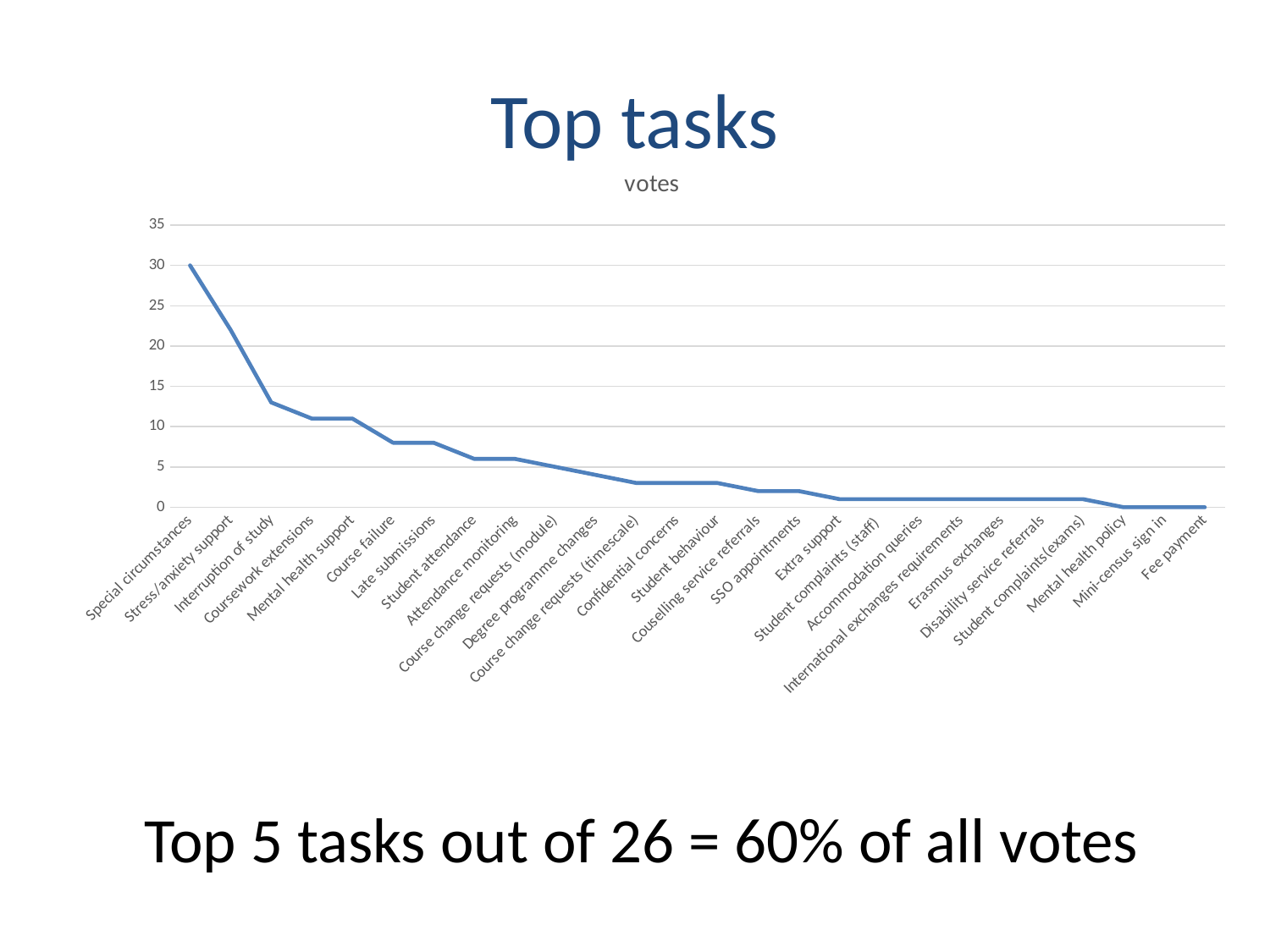
Is the value for Stress/anxiety support greater or less than 20? greater Which has more votes, Special circumstances or Stress/anxiety support? Special circumstances Is the value for Confidential concerns greater or less than 5? less Do the values rise or fall from left to right along the x axis? fall Is the value for Course failure greater or less than 10? less How many votes did Fee payment receive? 0 Which task received the most votes? Special circumstances How many votes did Special circumstances receive? 30 How many tasks are plotted on the chart? 26 What kind of chart is shown on the slide? line chart What is the title of the chart? votes